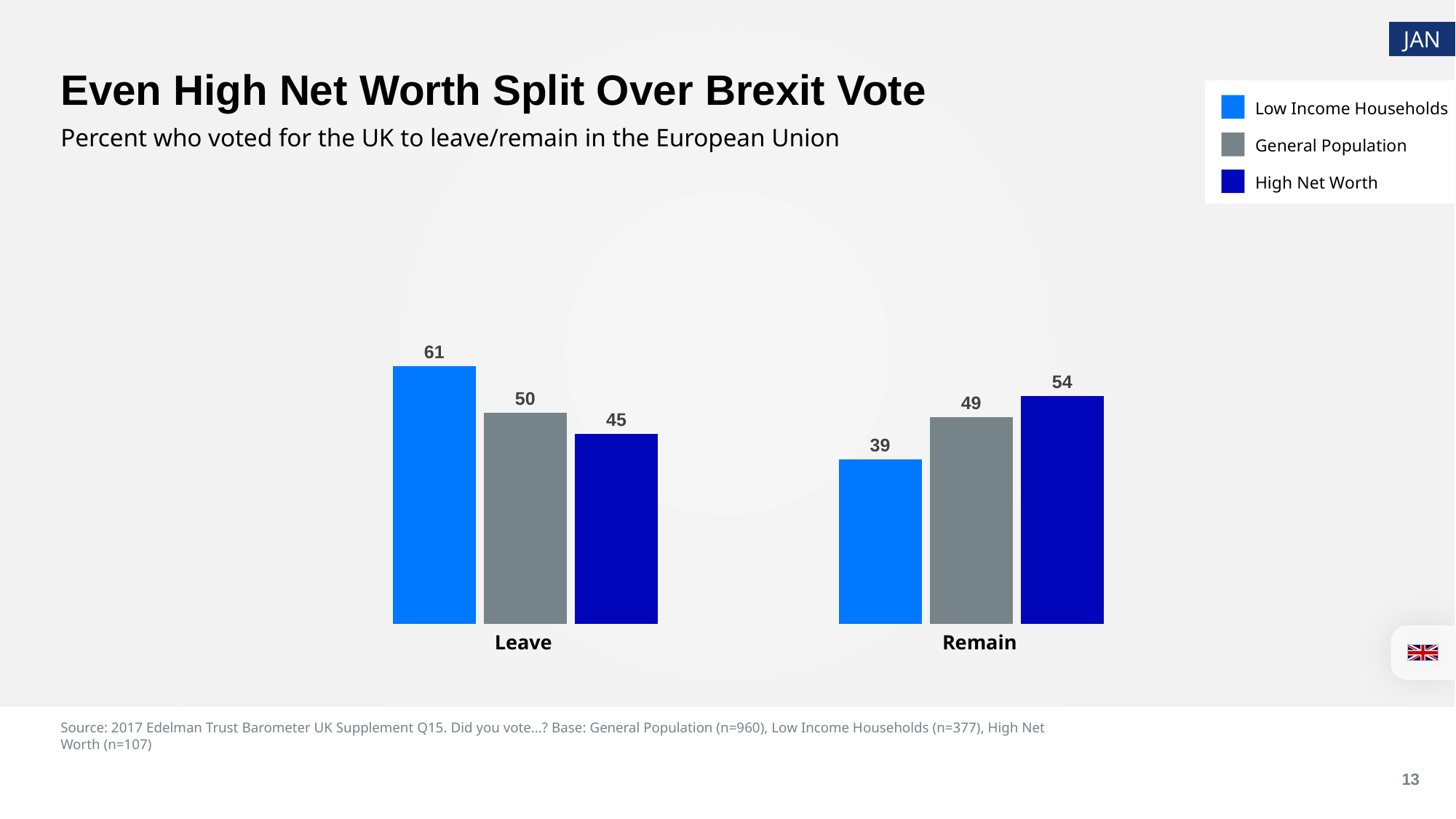
How many categories are shown on the x axis? 2 Which group has the highest value for Leave? Low Income Households What percent of High Net Worth respondents voted Remain? 54 What percent of Low Income Households voted Leave? 61 What type of chart is shown on the slide? Bar chart Which is larger for High Net Worth: Leave or Remain? Remain What is the difference between the Low Income Households values for Leave and Remain? 22 What is the General Population value for Remain? 49 Which group has the lowest value for Remain? Low Income Households What is the High Net Worth value for Leave? 45 What is the difference between the High Net Worth values for Remain and Leave? 9 How many series does the legend list? 3